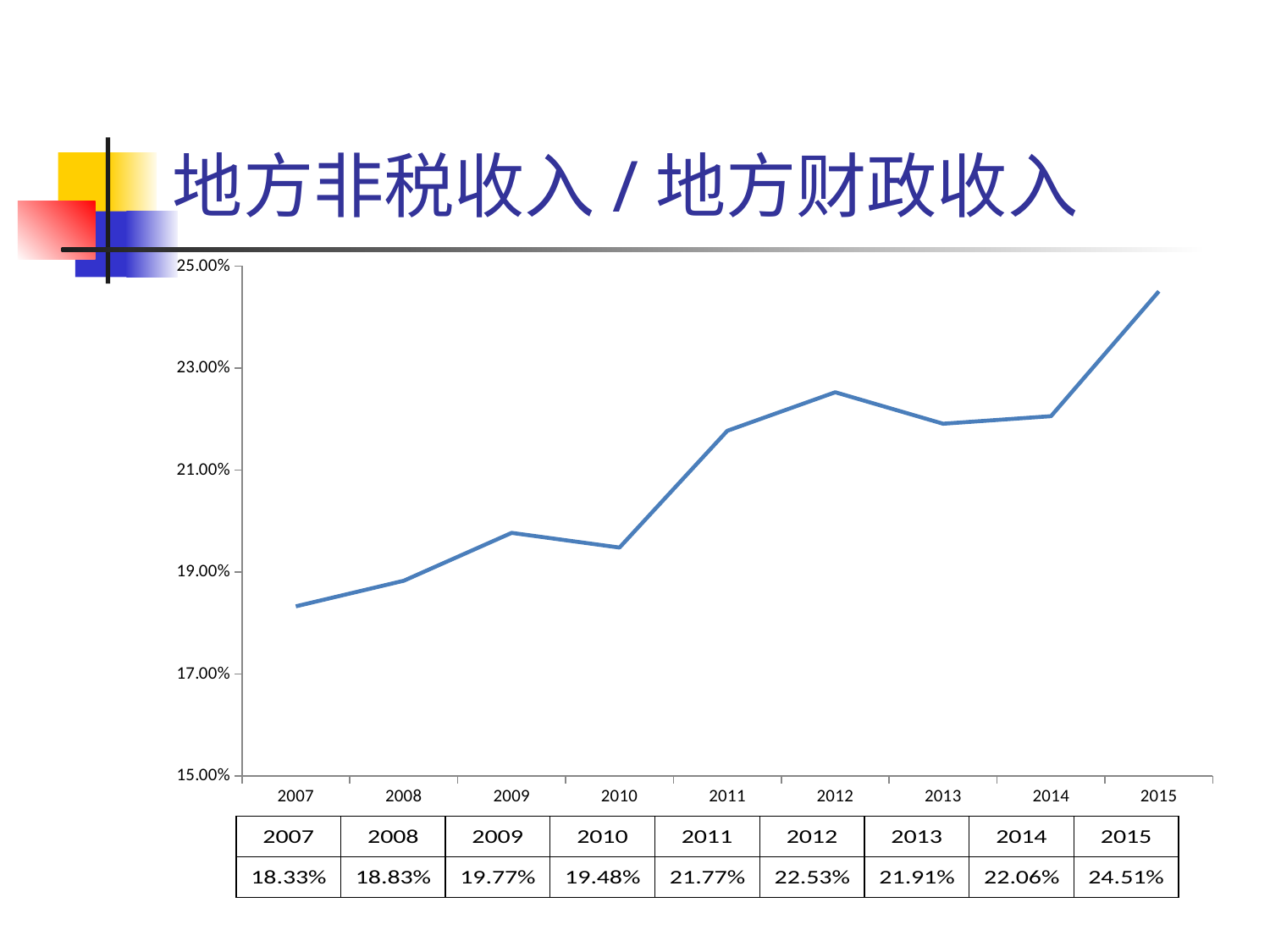
Which year has the lowest value? 2007 Does the value rise or fall from 2012 to 2013? fall What kind of chart is shown on the slide? line chart What is the difference between the values for 2011 and 2010? 2.29% Is the value for 2013 greater or less than 21.00%? greater Which is larger, the value for 2009 or the value for 2010? 2009 What is the difference between the values for 2015 and 2014? 2.45% How many years are plotted on the chart? 9 What is the value for 2012? 22.53% What is the value for 2007? 18.33% What is the value for 2015? 24.51% Which year has the highest value? 2015